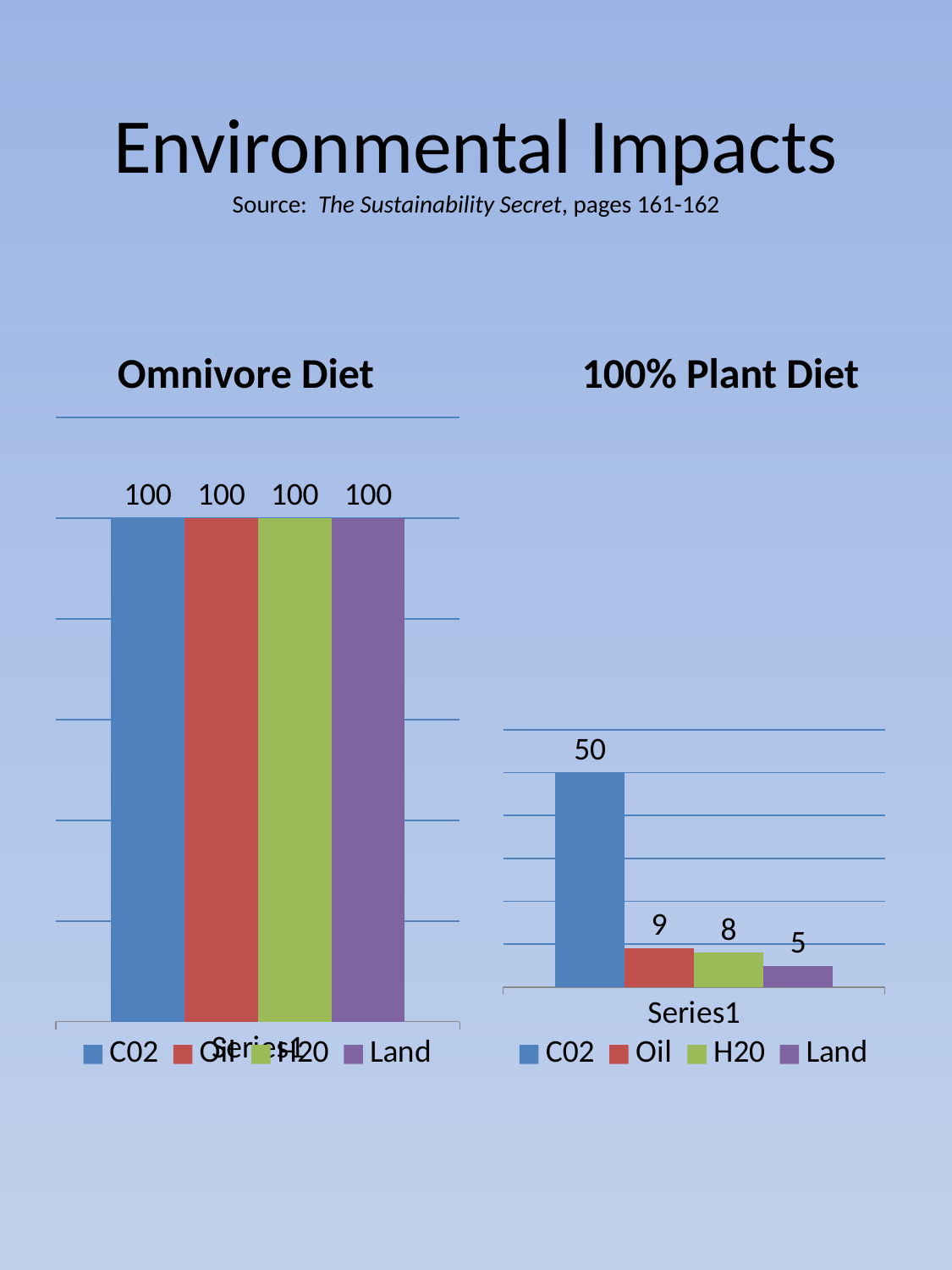
What is the difference between the Land value in the Omnivore Diet chart and the Land value in the 100% Plant Diet chart? 95 In the 100% Plant Diet chart, what is the difference between the C02 value and the Oil value? 41 How many series does the legend of the Omnivore Diet chart list? 4 In the 100% Plant Diet chart, what is the value for C02? 50 In the 100% Plant Diet chart, which series has the lowest value? Land In the 100% Plant Diet chart, what is the value for Land? 5 What kind of chart is the 100% Plant Diet chart? bar chart In the 100% Plant Diet chart, which is larger, the value for C02 or the value for H20? C02 In the Omnivore Diet chart, what is the value for H20? 100 What is the title of the chart on the left side of the slide? Omnivore Diet In the 100% Plant Diet chart, which series has the highest value? C02 In the 100% Plant Diet chart, what is the value for Oil? 9